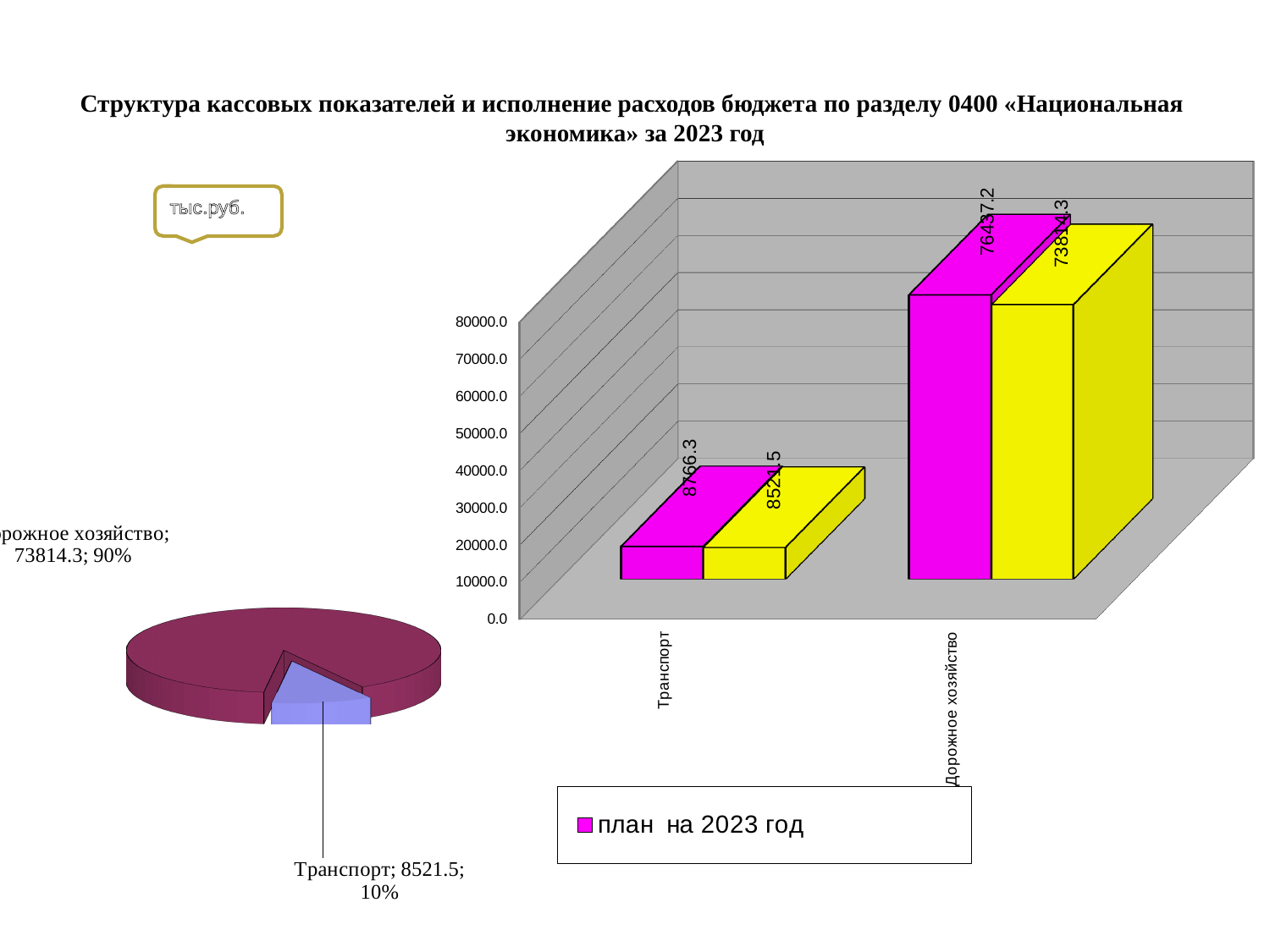
What kind of chart is the chart on the right of the slide? bar chart In the bar chart, what is the difference between the 'план на 2023 год' values for Дорожное хозяйство and Транспорт? 67670.9 How many categories are shown on the x axis of the bar chart? 2 In the pie chart, what value is shown for Дорожное хозяйство? 73814.3 In the bar chart, what is the value of the 'план на 2023 год' bar for Дорожное хозяйство? 76437.2 In the bar chart, is the 'план на 2023 год' value for Дорожное хозяйство greater or less than 70000.0? greater In the bar chart, what is the value of the yellow bar for Транспорт? 8521.5 In the bar chart, which category has the highest 'план на 2023 год' value? Дорожное хозяйство In the bar chart, what is the value of the 'план на 2023 год' bar for Транспорт? 8766.3 In the pie chart, what share does Транспорт have? 10% What kind of chart is the chart on the left of the slide? pie chart In the bar chart, what is the value of the yellow bar for Дорожное хозяйство? 73814.3